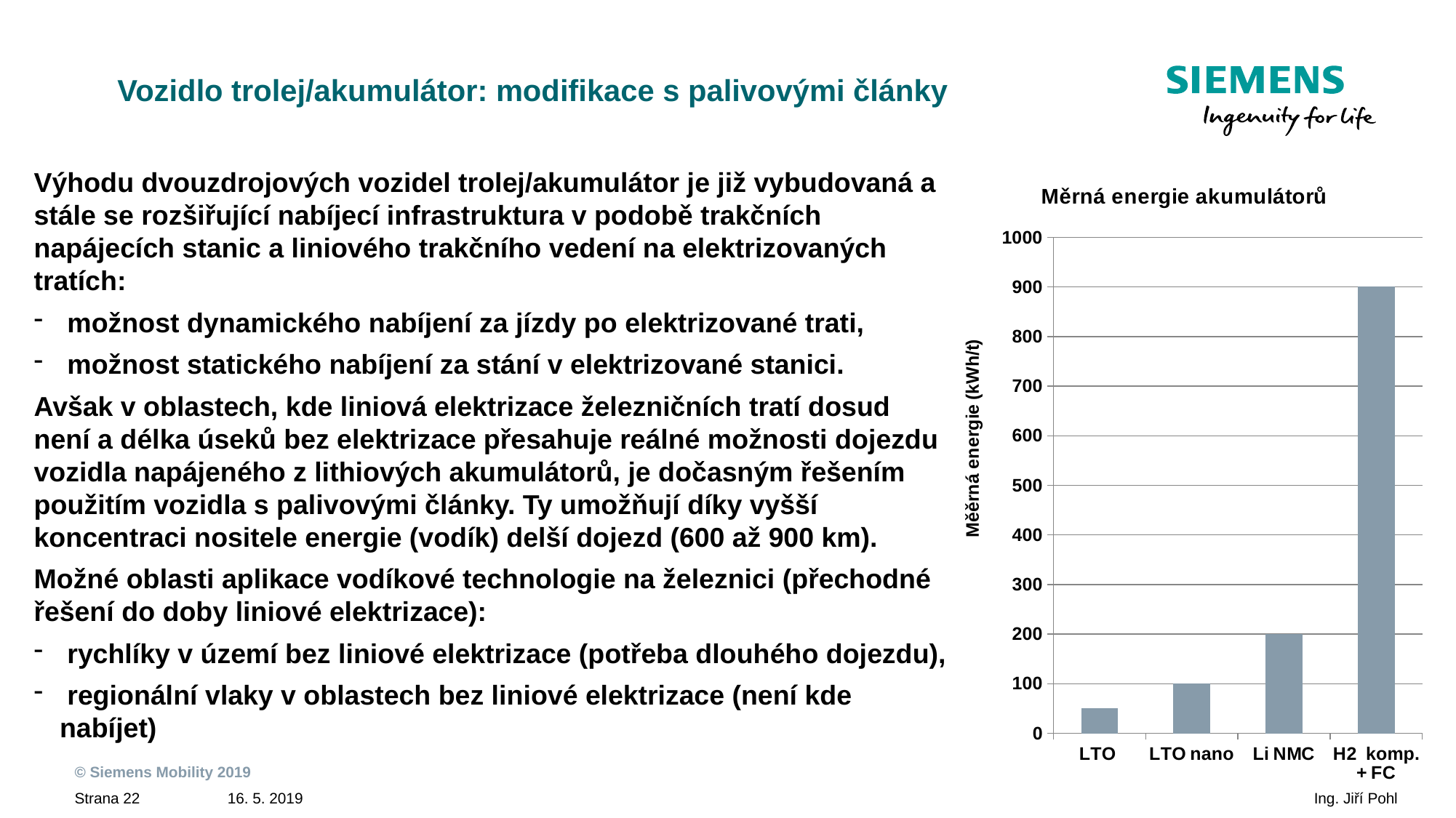
What is the label of the y axis of the chart? Měěrná energie (kWh/t) What is the value for LTO nano in the chart? 100 What kind of chart is shown on the slide? bar chart What is the difference between the values for H2 komp. + FC and Li NMC? 700 What is the title of the chart? Měrná energie akumulátorů Which is larger, the value for Li NMC or the value for LTO nano? Li NMC Which category has the lowest value in the chart? LTO What is the value for Li NMC in the chart? 200 Is the value for LTO greater or less than 100? less What is the value for H2 komp. + FC in the chart? 900 Which category has the highest value in the chart? H2 komp. + FC How many categories are shown on the x axis of the chart? 4